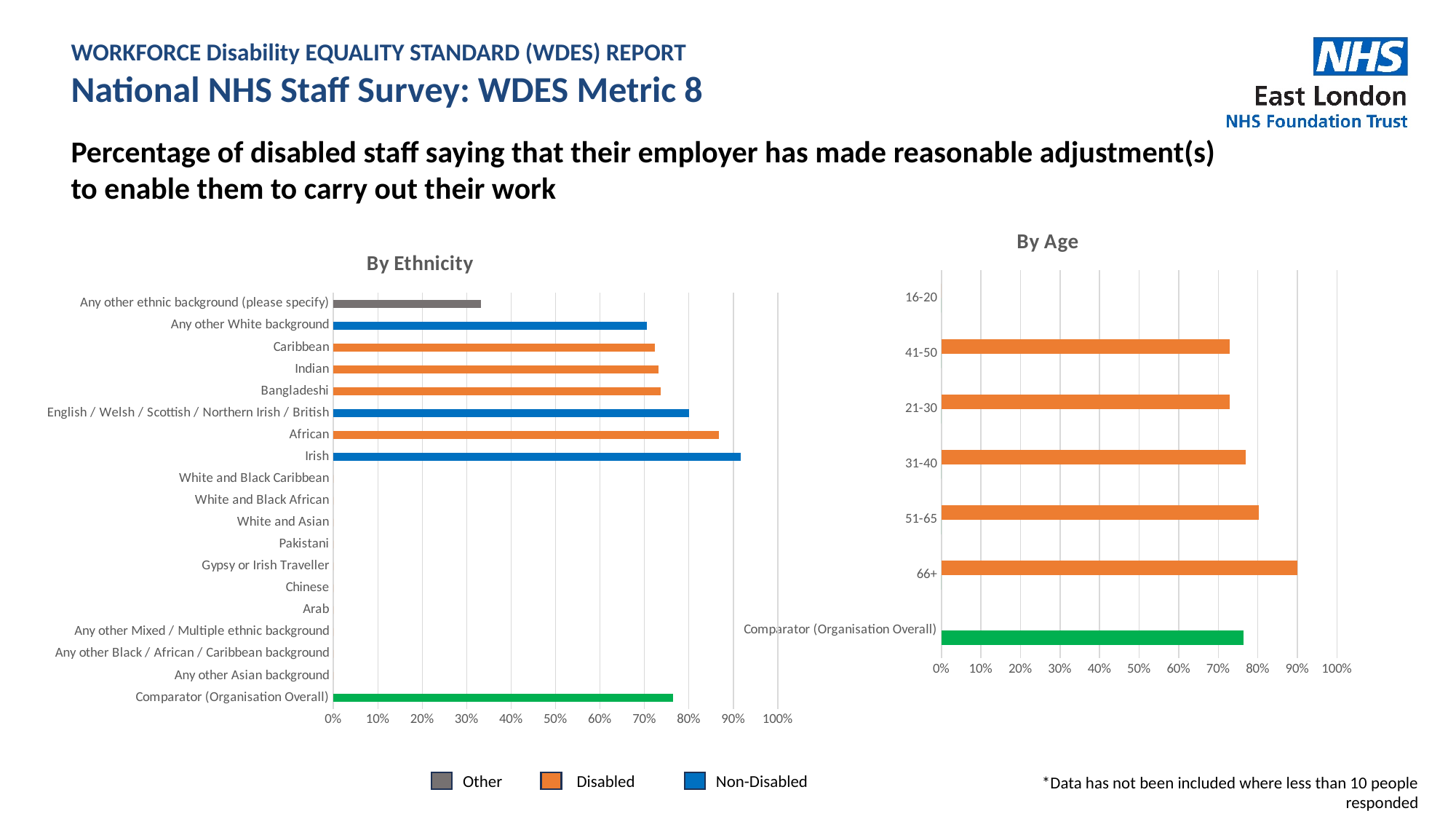
In the "By Age" chart, is the value for Comparator (Organisation Overall) greater or less than 70%? greater In the "By Ethnicity" chart, is the value for Irish greater or less than 80%? greater In the "By Ethnicity" chart, is the value for English / Welsh / Scottish / Northern Irish / British greater or less than 70%? greater In the "By Ethnicity" chart, which is larger, the value for African or the value for Bangladeshi? African How many series does the legend at the bottom of the slide list? 3 In the "By Age" chart, which is larger, the value for 51-65 or the value for 41-50? 51-65 In the "By Ethnicity" chart, which plotted category has the lowest value? Any other ethnic background (please specify) In the "By Age" chart, which age group has the highest value? 66+ What type of chart is the "By Ethnicity" chart? bar chart In the "By Ethnicity" chart, which ethnic group has the highest value? Irish